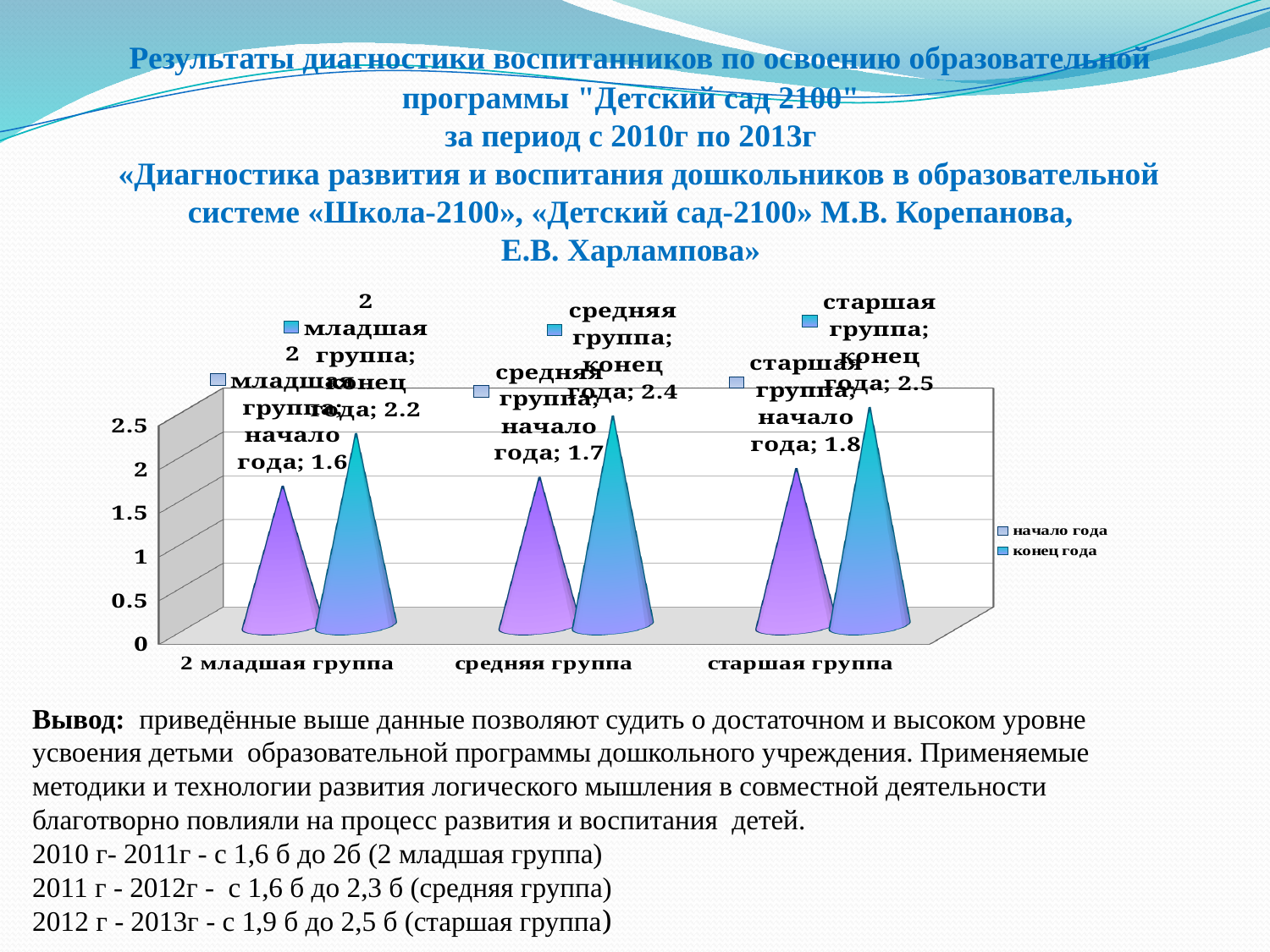
Which category has the highest "конец года" value? старшая группа Which is larger: the "конец года" value for "2 младшая группа" or the "начало года" value for "старшая группа"? конец года for 2 младшая группа Do the "начало года" values rise or fall from "2 младшая группа" to "старшая группа"? rise Which category has the lowest "начало года" value? 2 младшая группа What is the difference between the "конец года" and "начало года" values for "средняя группа"? 0.7 How many series does the chart legend list? 2 What are the two series names listed in the chart legend? начало года, конец года What is the value for "конец года" in the "старшая группа" category? 2.5 How many categories are shown on the x axis of the chart? 3 What is the value for "конец года" in the "средняя группа" category? 2.4 What is the value for "начало года" in the "старшая группа" category? 1.8 What is the value for "начало года" in the "2 младшая группа" category? 1.6